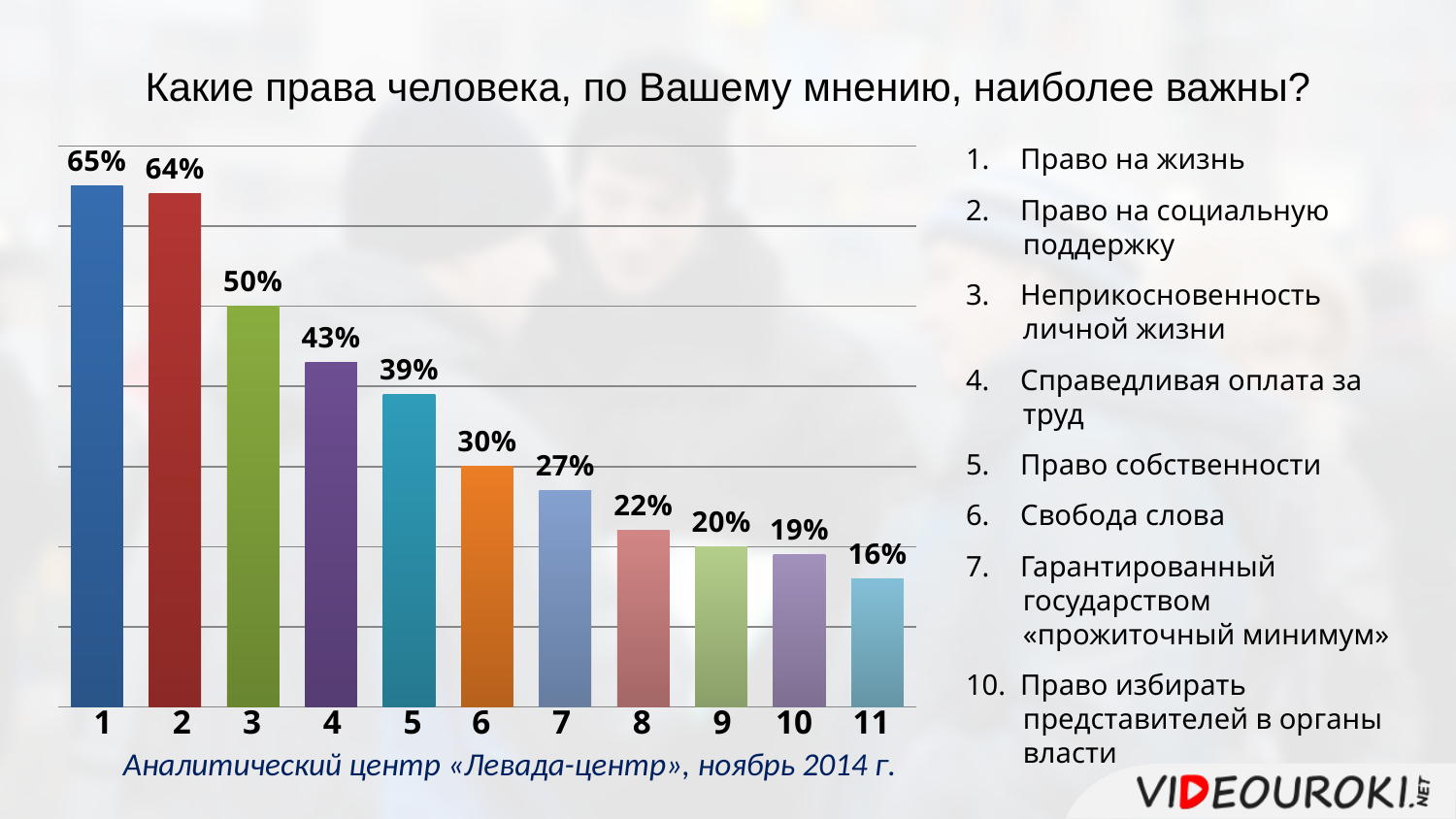
What kind of chart is shown on the slide? bar chart What is the value for category 1 (Право на жизнь)? 65% What is the difference between the values for category 3 and category 4? 7% Which category has the highest value? 1 What is the title of the chart? Какие права человека, по Вашему мнению, наиболее важны? How many categories are shown on the chart? 11 Which is larger, the value for category 6 or the value for category 7? category 6 What is the value for category 8? 22% Which category has the lowest value? 11 Do the values rise or fall from category 1 to category 11? fall What is the difference between the values for category 1 and category 2? 1% What is the value for category 5 (Право собственности)? 39%